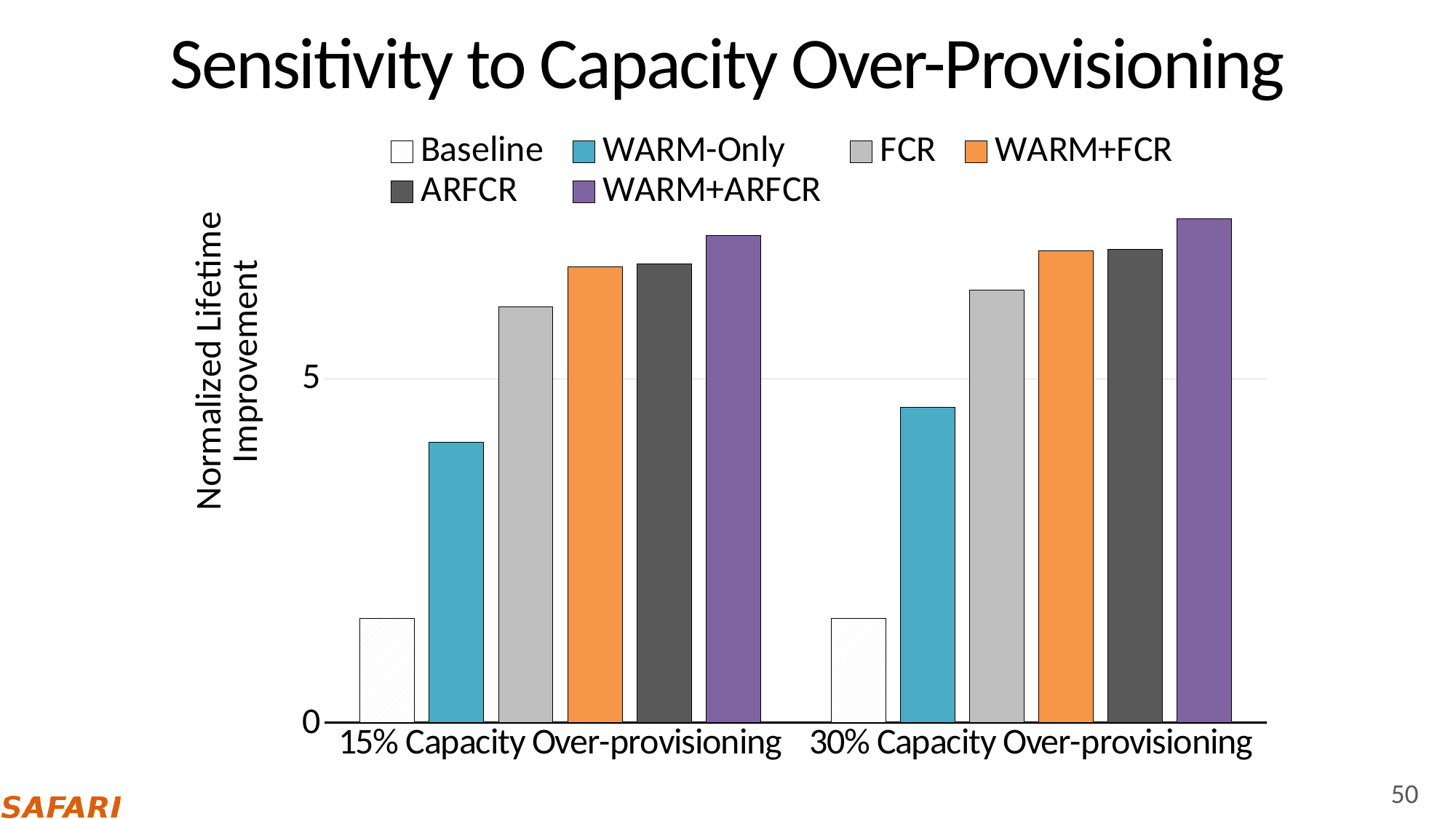
Which is larger at 15% Capacity Over-provisioning: FCR or WARM-Only? FCR What kind of chart is shown on the slide? bar chart What is the title of the y axis? Normalized Lifetime Improvement How many series does the legend list? 6 Which series has the highest value for 15% Capacity Over-provisioning? WARM+ARFCR Which series has the highest value for 30% Capacity Over-provisioning? WARM+ARFCR How many categories are shown on the x axis? 2 Which series has the lowest value for 30% Capacity Over-provisioning? Baseline Is the value for WARM-Only at 15% Capacity Over-provisioning greater or less than 5? less Is the value for WARM+FCR at 30% Capacity Over-provisioning greater or less than 5? greater Is the value for FCR at 15% Capacity Over-provisioning greater or less than 5? greater Which is larger: the WARM-Only value at 15% Capacity Over-provisioning or at 30% Capacity Over-provisioning? 30% Capacity Over-provisioning